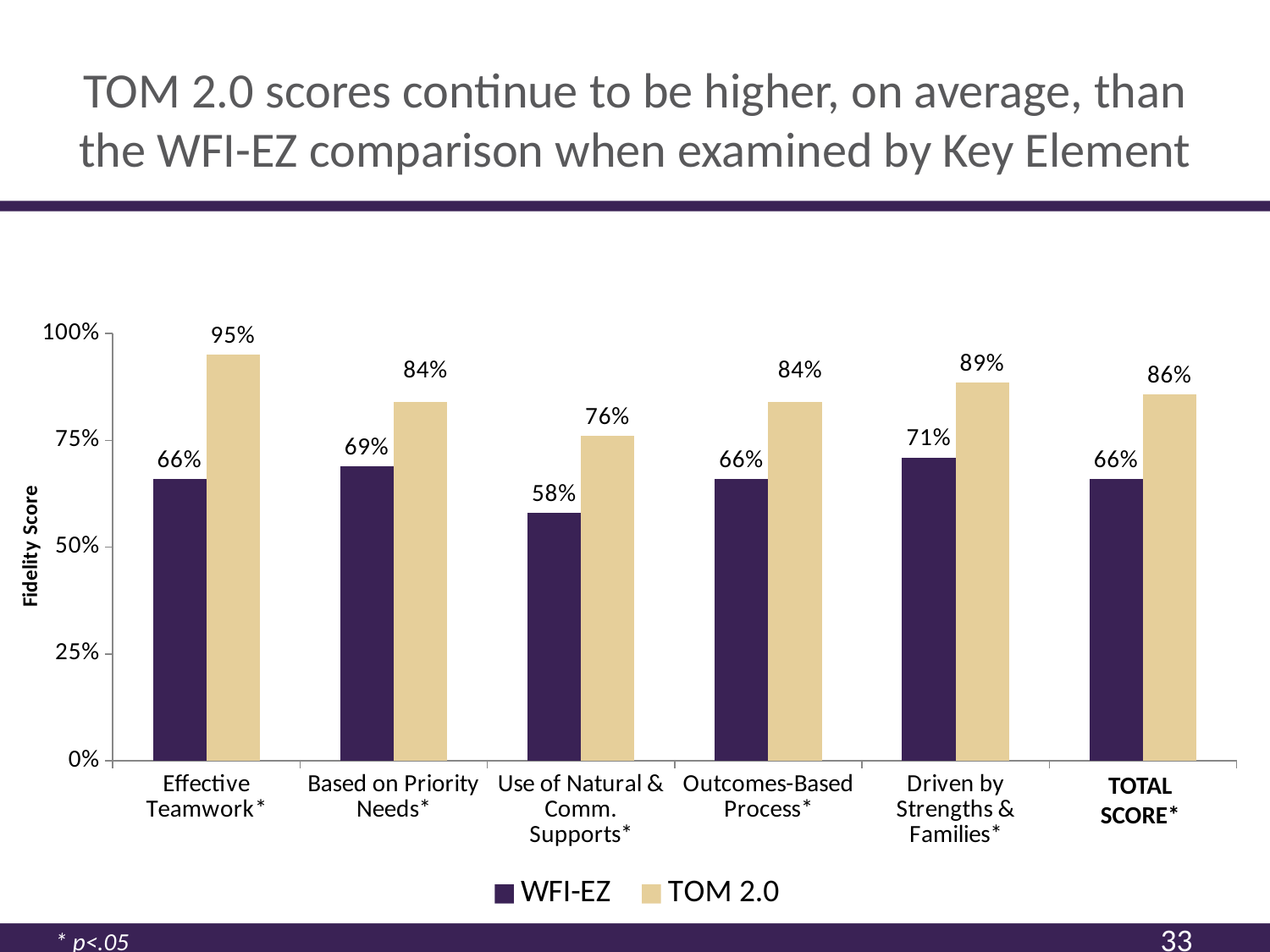
What is the TOM 2.0 value for Effective Teamwork*? 95% What is the WFI-EZ value for Driven by Strengths & Families*? 71% What kind of chart is shown on the slide? Bar chart Which category has the lowest WFI-EZ value? Use of Natural & Comm. Supports* What is the label of the y axis? Fidelity Score How many series does the legend list? 2 What is the WFI-EZ value for Use of Natural & Comm. Supports*? 58% Which is larger for Outcomes-Based Process*: the WFI-EZ value or the TOM 2.0 value? TOM 2.0 Which category has the highest TOM 2.0 value? Effective Teamwork* How many categories are shown on the x axis? 6 What is the TOM 2.0 value for TOTAL SCORE*? 86% What is the difference between the TOM 2.0 and WFI-EZ values for Effective Teamwork*? 29%